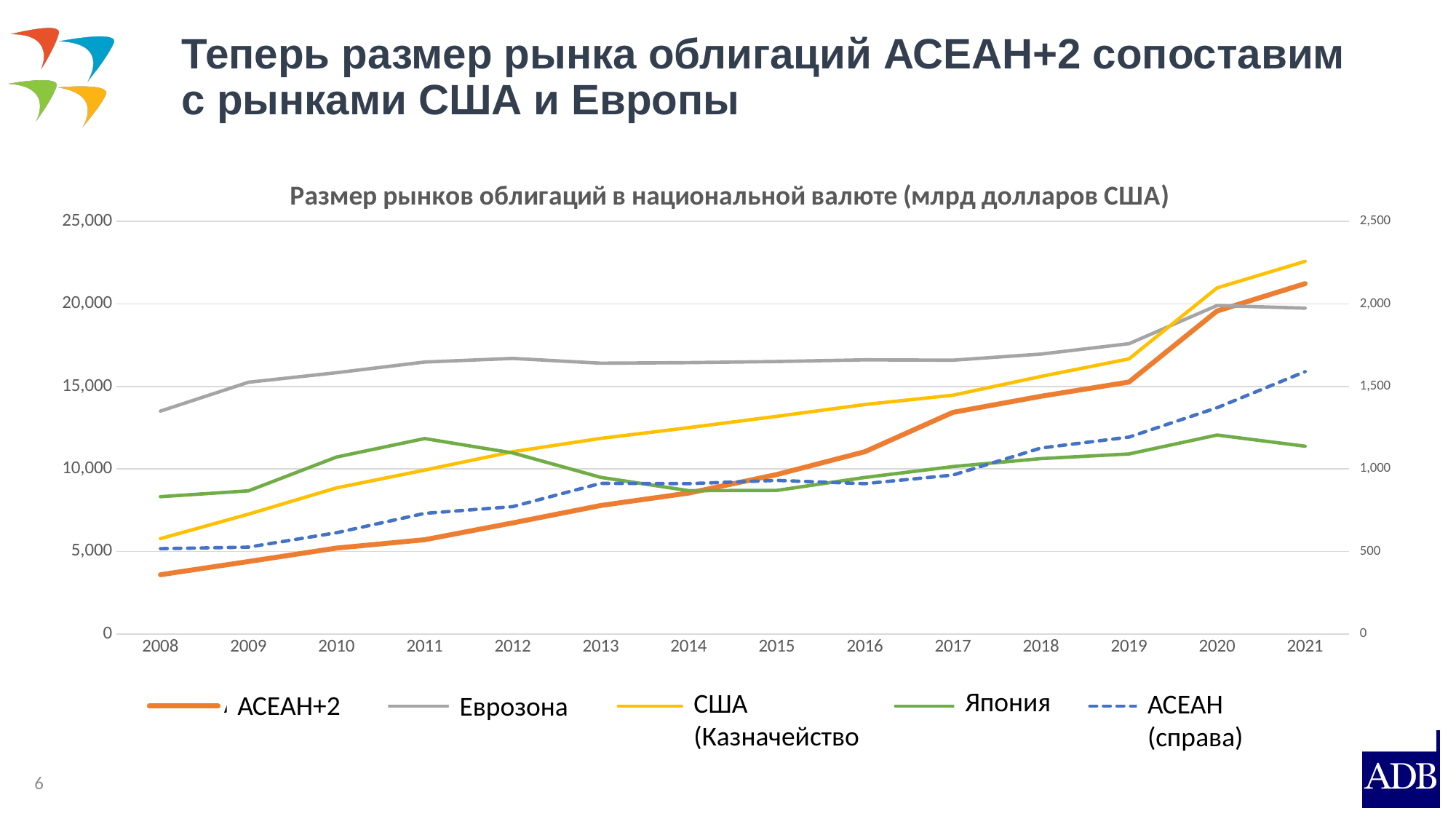
In 2010, which is larger: Япония or АСЕАН+2? Япония Which series is plotted on the right-hand axis? АСЕАН (справа) Is the value for Еврозона in 2008 greater or less than 15,000? less How many series does the legend list? 5 In 2021, which is larger: США (Казначейство) or Еврозона? США (Казначейство) Does the value for АСЕАН+2 rise or fall from 2008 to 2021? rise How many years are shown on the x axis? 14 Is the value for АСЕАН+2 in 2021 greater or less than 20,000? greater What is the title of the chart? Размер рынков облигаций в национальной валюте (млрд долларов США) Which series has the highest value in 2021? США (Казначейство) What kind of chart is shown on the slide? line chart Is the value for Япония in 2011 greater or less than 10,000? greater